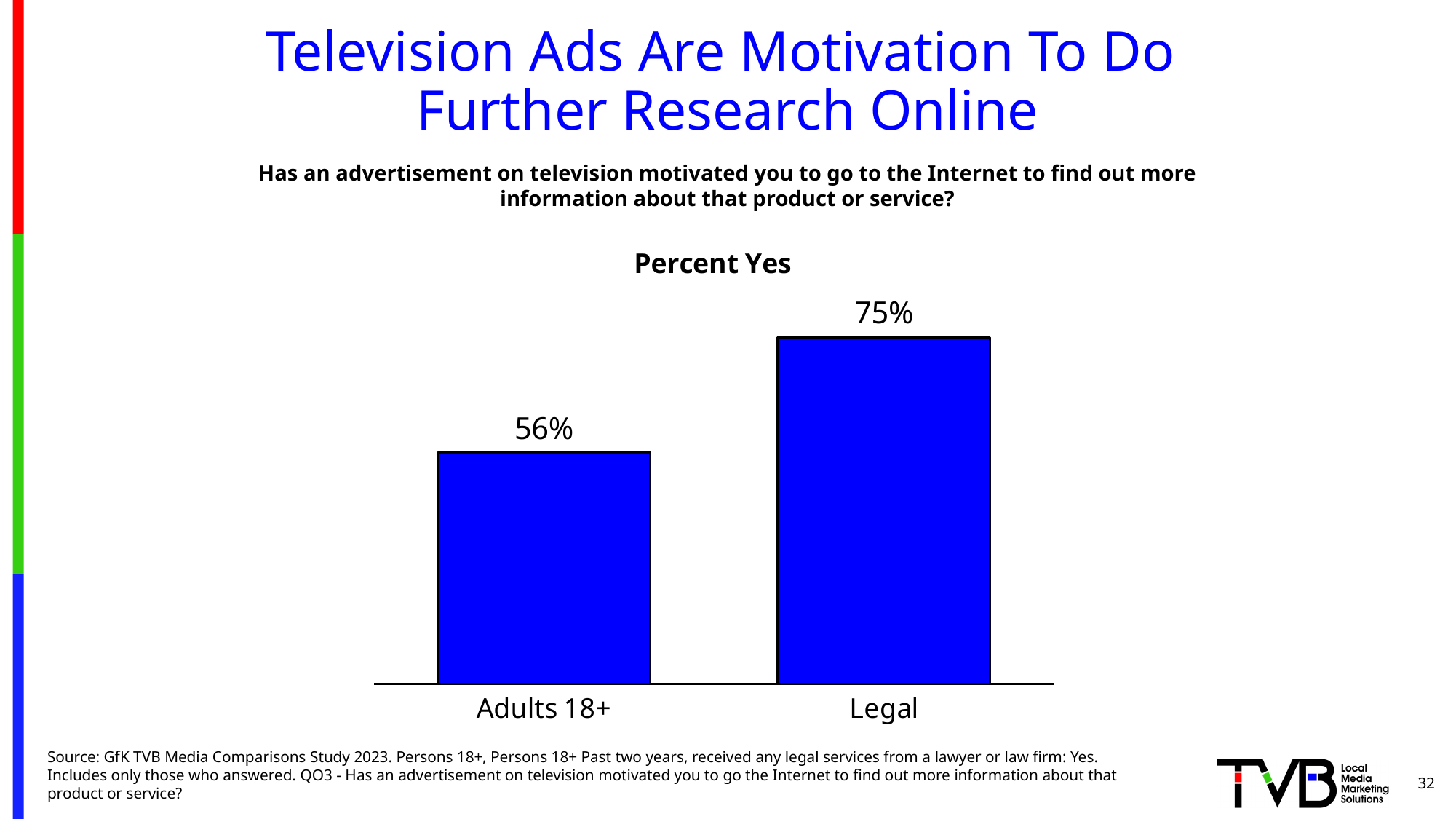
What is the title of the chart? Percent Yes What kind of chart is shown on the slide? Bar chart Which category has the highest Percent Yes value? Legal What is the Percent Yes value for Adults 18+? 56% What colour are the bars in the chart? Blue What is the Percent Yes value for Legal? 75% What is the difference in Percent Yes between Legal and Adults 18+? 19% How many categories are shown in the chart? 2 Which is larger, the Percent Yes for Legal or for Adults 18+? Legal Which category has the lowest Percent Yes value? Adults 18+